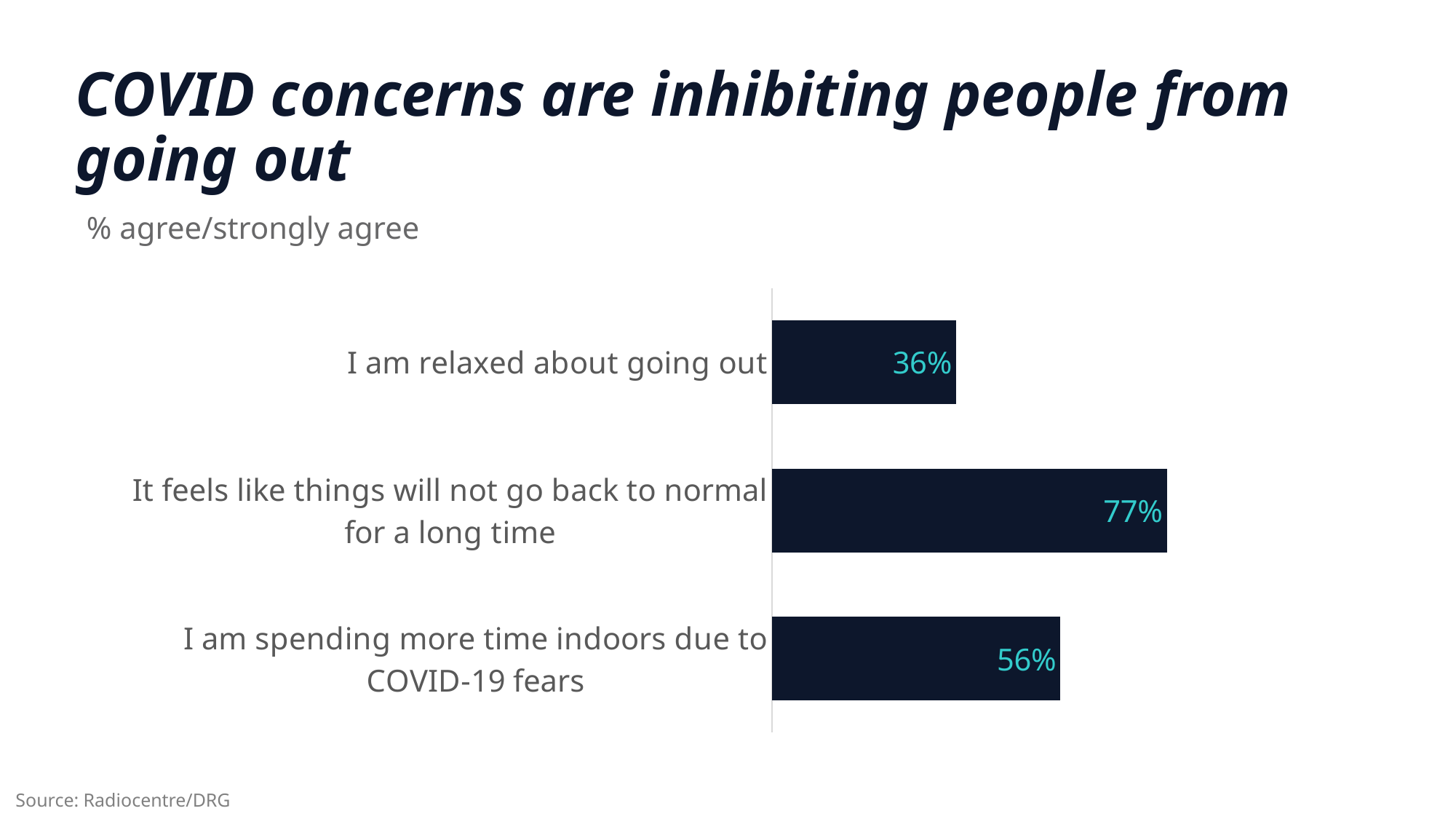
What is the difference in percentage points between "It feels like things will not go back to normal for a long time" and "I am relaxed about going out"? 41 What percentage agree or strongly agree with "I am relaxed about going out"? 36% Which statement has the highest percentage of agreement? It feels like things will not go back to normal for a long time What is the difference in percentage points between "It feels like things will not go back to normal for a long time" and "I am spending more time indoors due to COVID-19 fears"? 21 How many statements are shown in the chart? 3 What percentage agree or strongly agree with "I am spending more time indoors due to COVID-19 fears"? 56% Which has a higher percentage: "I am spending more time indoors due to COVID-19 fears" or "I am relaxed about going out"? I am spending more time indoors due to COVID-19 fears Which statement has the lowest percentage of agreement? I am relaxed about going out What measure does the chart subtitle say the values represent? % agree/strongly agree What is the source cited for the chart data? Radiocentre/DRG What percentage agree or strongly agree that "It feels like things will not go back to normal for a long time"? 77% What type of chart is shown on the slide? Bar chart